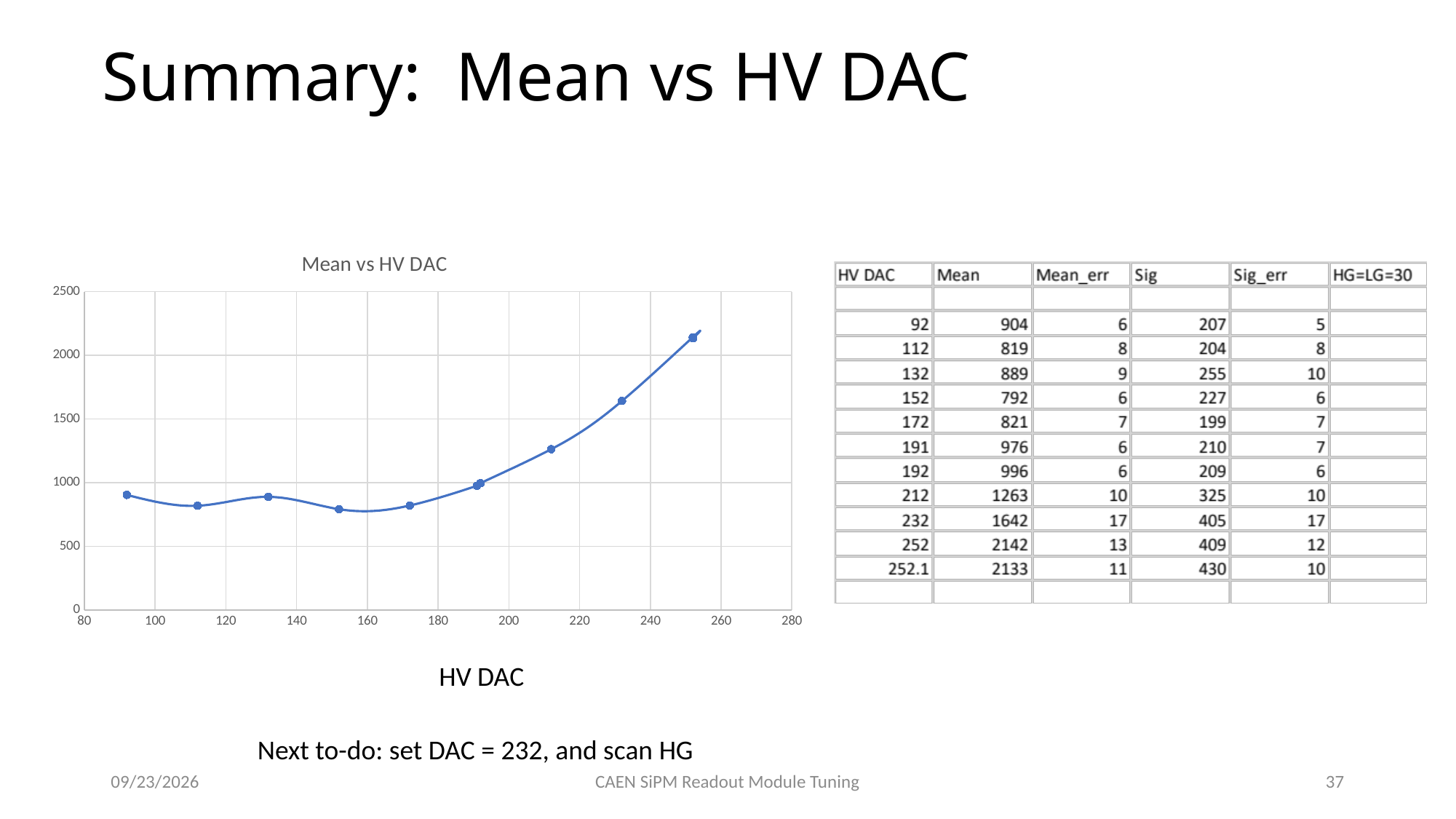
Does the mean value rise or fall as HV DAC increases from 180 to 260? rise Which has the larger mean value, HV DAC 232 or HV DAC 212? HV DAC 232 What is the label of the x axis of the chart? HV DAC Which has the larger mean value, HV DAC 212 or HV DAC 172? HV DAC 212 What kind of chart is shown on the slide? line chart Is the mean value at HV DAC 212 greater or less than 1000? greater According to the table on the slide, what is the Mean at HV DAC 252? 2142 According to the table on the slide, what is the Mean at HV DAC 232? 1642 Is the mean value at HV DAC 232 greater or less than 1500? greater Is the mean value at HV DAC 152 greater or less than 1000? less What is the title of the chart? Mean vs HV DAC